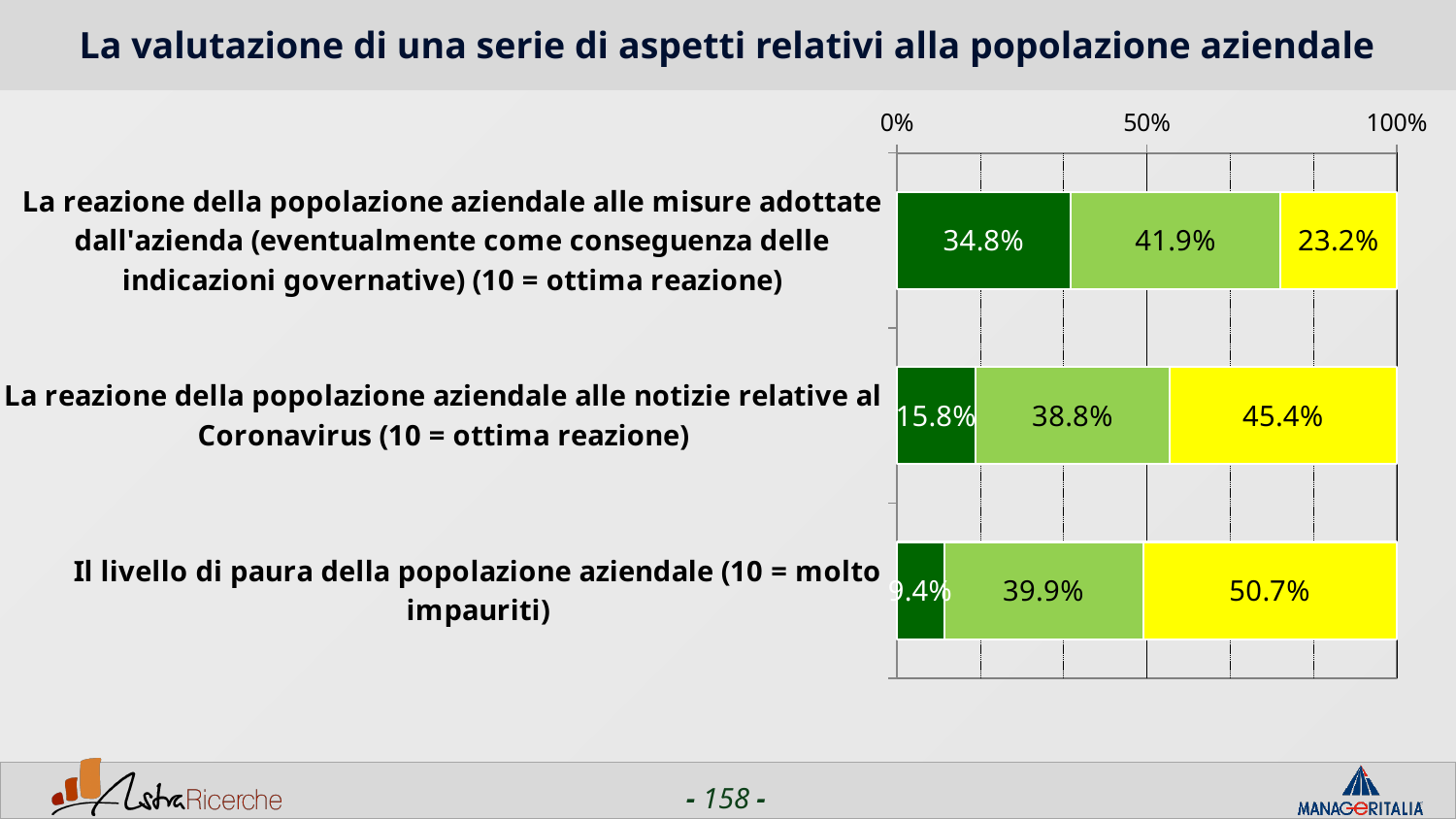
What is the value of the light green segment for 'La reazione della popolazione aziendale alle notizie relative al Coronavirus'? 38.8% What is the value of the dark green segment for 'Il livello di paura della popolazione aziendale (10 = molto impauriti)'? 9.4% Which category has the highest yellow segment value? Il livello di paura della popolazione aziendale (10 = molto impauriti) Which category has the lowest dark green segment value? Il livello di paura della popolazione aziendale (10 = molto impauriti) What is the title of the slide? La valutazione di una serie di aspetti relativi alla popolazione aziendale Which is larger: the dark green segment for 'La reazione della popolazione aziendale alle misure adottate dall'azienda' or the dark green segment for 'La reazione della popolazione aziendale alle notizie relative al Coronavirus'? La reazione della popolazione aziendale alle misure adottate dall'azienda What is the difference between the yellow segment values for 'Il livello di paura della popolazione aziendale' and 'La reazione della popolazione aziendale alle misure adottate dall'azienda'? 27.5% What is the total of the stacked bar for 'La reazione della popolazione aziendale alle notizie relative al Coronavirus'? 100.0% What is the value of the yellow segment for 'Il livello di paura della popolazione aziendale (10 = molto impauriti)'? 50.7% What is the value of the dark green segment for 'La reazione della popolazione aziendale alle misure adottate dall'azienda'? 34.8% How many categories (bars) does the chart show? 3 What kind of chart is shown on the slide? stacked bar chart